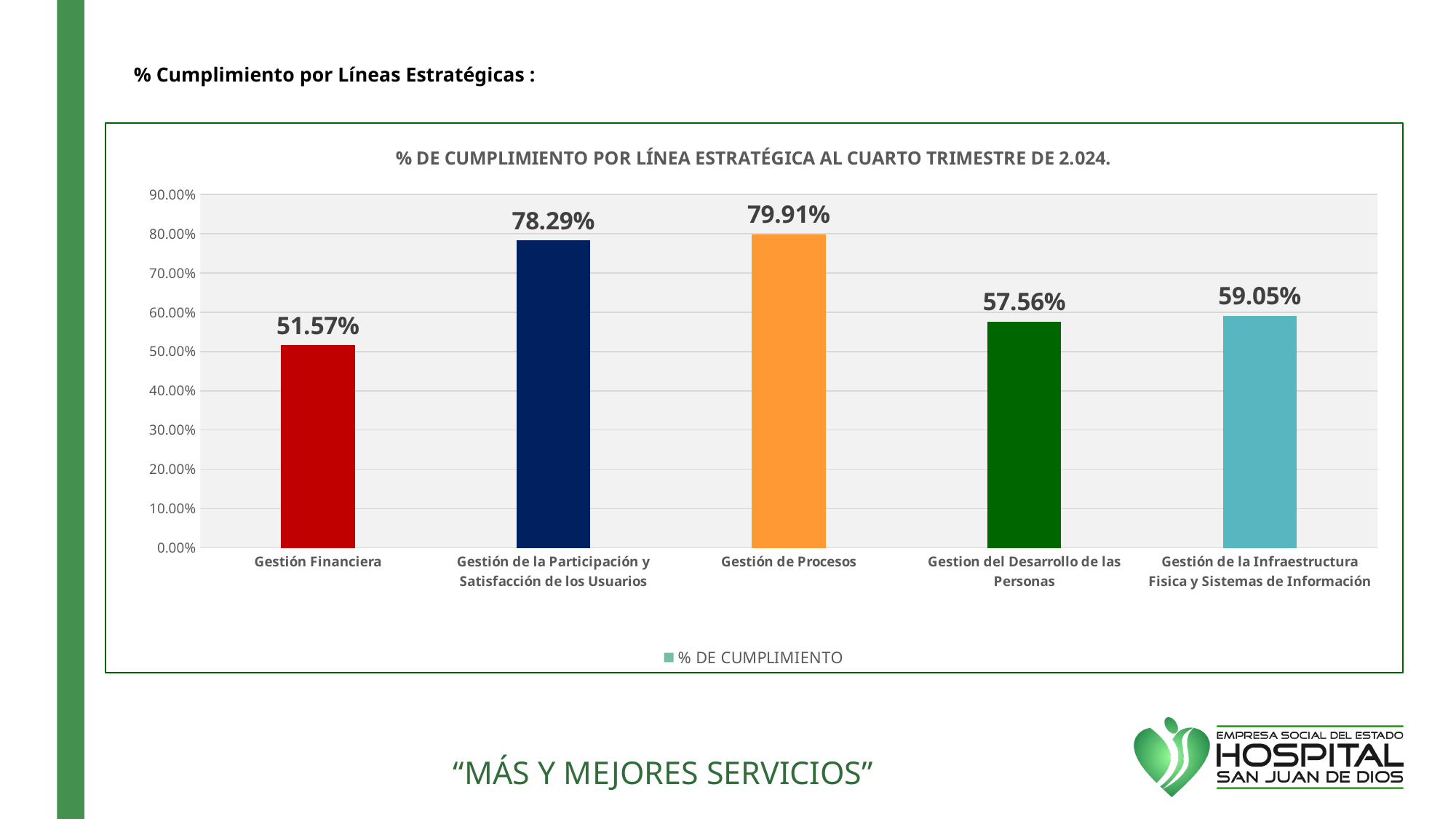
What is the value for Gestión Financiera? 51.57% What kind of chart is shown? bar chart What is the value for Gestión de Procesos? 79.91% What is the value for Gestión de la Infraestructura Fisica y Sistemas de Información? 59.05% How many categories are shown on the x axis? 5 Is the value for Gestion del Desarrollo de las Personas greater or less than 60.00%? less What is the difference between the values for Gestión de Procesos and Gestión Financiera? 28.34% What is the title of the chart? % DE CUMPLIMIENTO POR LÍNEA ESTRATÉGICA AL CUARTO TRIMESTRE DE 2.024. Which category has the highest value? Gestión de Procesos Which is larger, the value for Gestión de la Participación y Satisfacción de los Usuarios or the value for Gestion del Desarrollo de las Personas? Gestión de la Participación y Satisfacción de los Usuarios How many series does the legend list? 1 Which category has the lowest value? Gestión Financiera